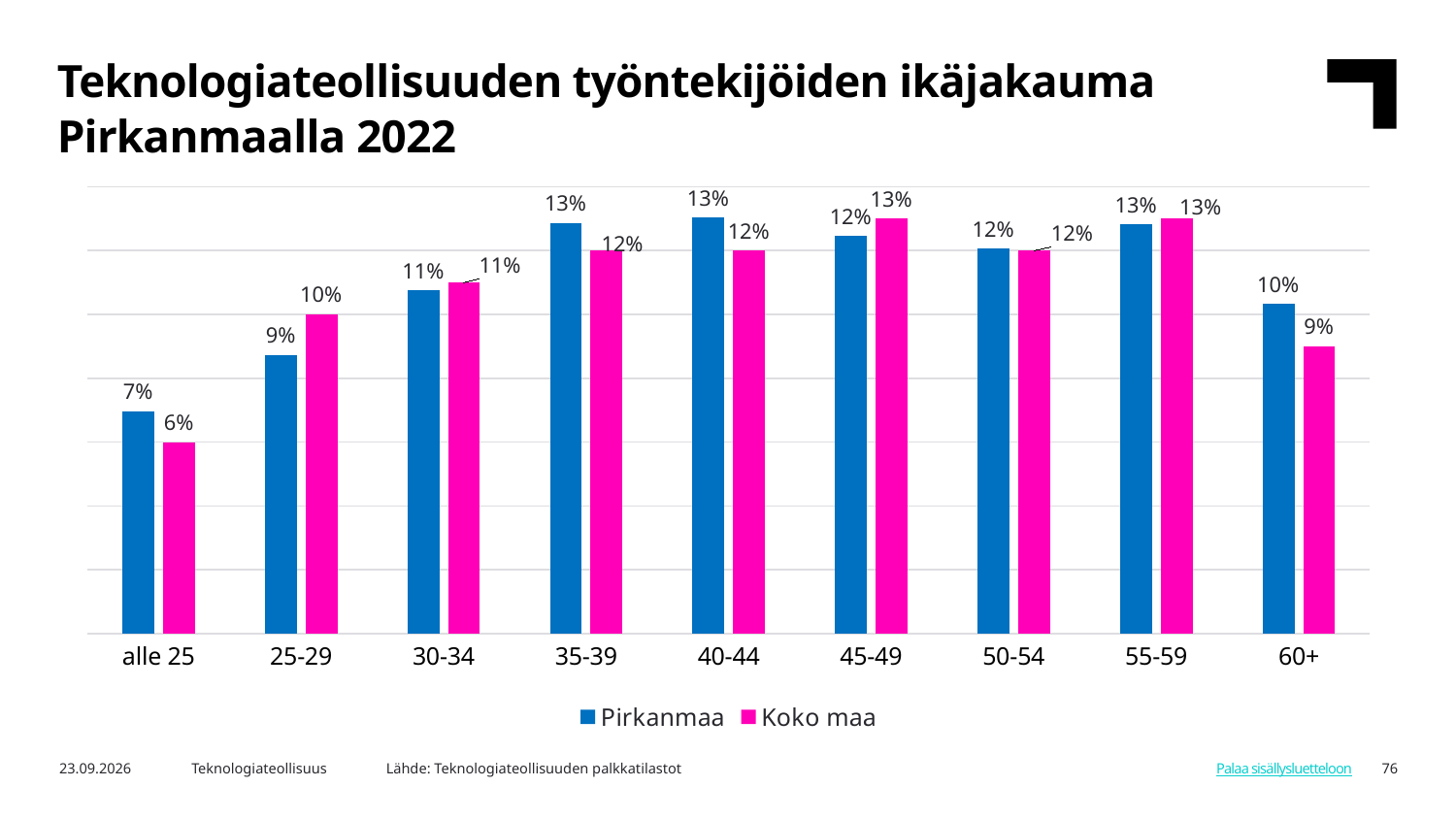
How many age groups are shown on the x axis? 9 What is the value for Koko maa in the 60+ age group? 9% Which age group has the lowest value for Pirkanmaa? alle 25 What is the value for Pirkanmaa in the 25-29 age group? 9% Which age group has the lowest value for Koko maa? alle 25 In the 60+ age group, which series has the larger value, Pirkanmaa or Koko maa? Pirkanmaa What is the value for Koko maa in the alle 25 age group? 6% In the 45-49 age group, which series has the larger value, Pirkanmaa or Koko maa? Koko maa What is the value for Pirkanmaa in the 35-39 age group? 13% What kind of chart is shown on the slide? Bar chart How many series does the legend list? 2 What is the difference between the Koko maa and Pirkanmaa values in the 25-29 age group? 1%